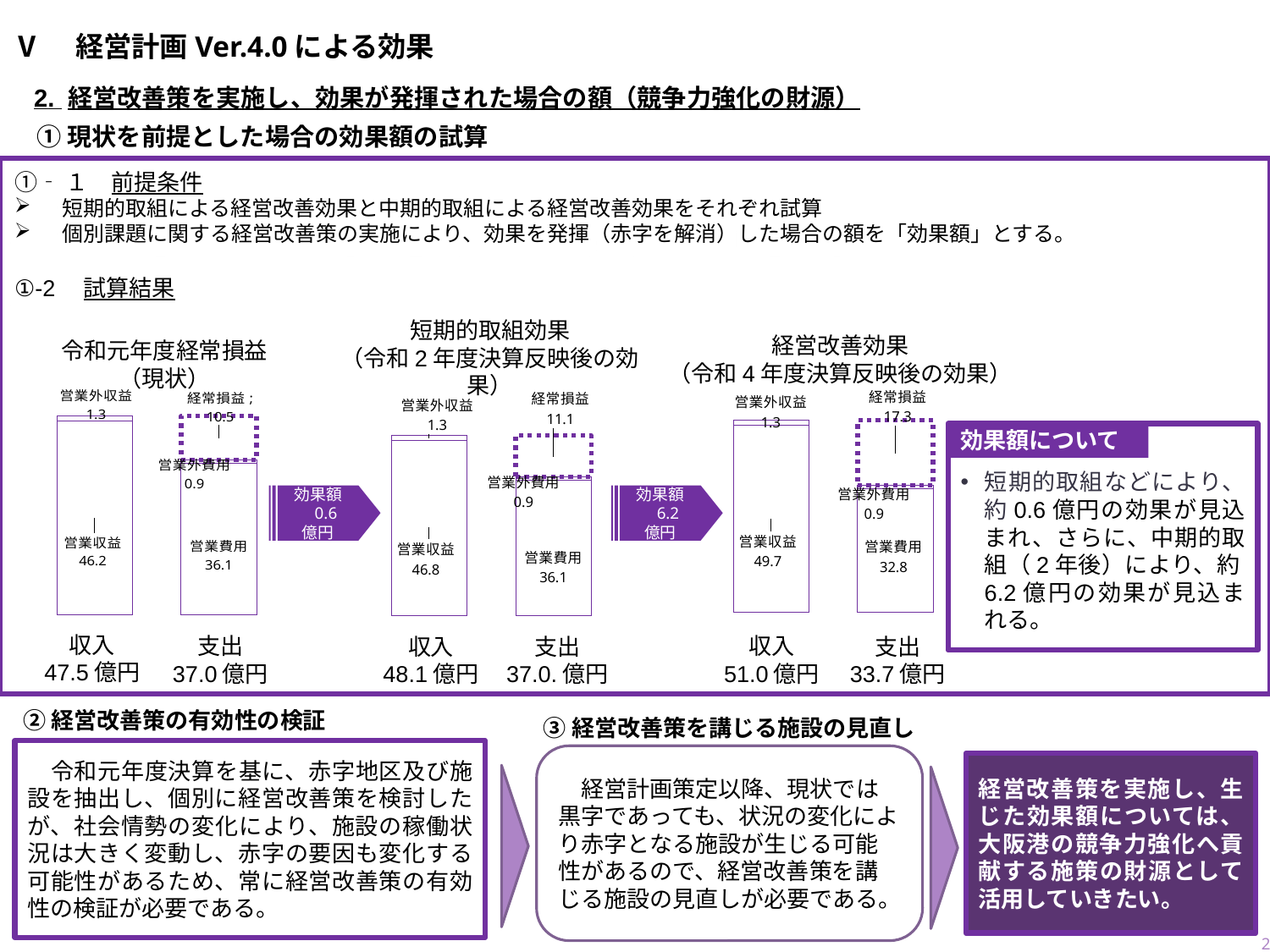
「令和元年度経常損益（現状）」のチャートで、営業収益の値はいくらですか？ 46.2 「令和元年度経常損益（現状）」のチャートで、収入の合計はいくらですか？ 47.5億円 「経営改善効果（令和4年度決算反映後の効果）」のチャートで、支出の合計はいくらですか？ 33.7億円 「令和元年度経常損益（現状）」のチャートで、営業費用の値はいくらですか？ 36.1 「短期的取組効果」から「経営改善効果」への矢印に示されている効果額はいくらですか？ 6.2億円 「経営改善効果（令和4年度決算反映後の効果）」のチャートで、営業収益と営業費用の差はいくらですか？ 16.9 「短期的取組効果」のチャートと「経営改善効果」のチャートでは、営業費用はどちらが大きいですか？ 短期的取組効果 「経営改善効果（令和4年度決算反映後の効果）」のチャートで、営業収益の値はいくらですか？ 49.7 3つのチャートのうち、営業収益が最も小さいのはどれですか？ 令和元年度経常損益（現状） 3つのチャートのうち、経常損益が最も大きいのはどれですか？ 経営改善効果（令和4年度決算反映後の効果） 「令和元年度経常損益（現状）」のチャートは、どの種類のチャートですか？ 積み上げ棒グラフ 「短期的取組効果（令和2年度決算反映後の効果）」のチャートで、経常損益の値はいくらですか？ 11.1